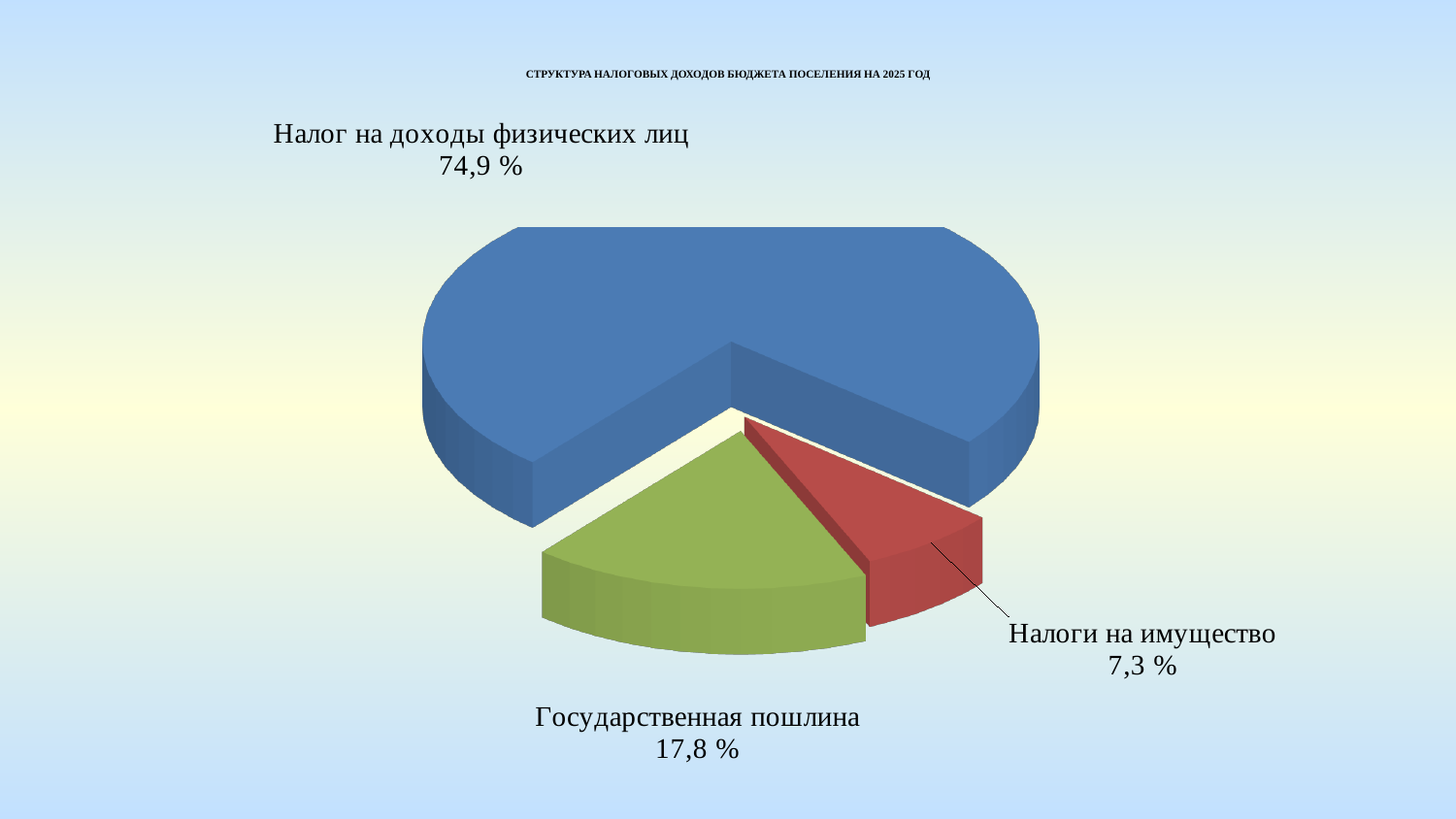
Какова доля налогов на имущество? 7,3 % На сколько процентных пунктов доля налога на доходы физических лиц больше доли государственной пошлины? 57,1 Какая категория имеет наибольшую долю в структуре налоговых доходов? Налог на доходы физических лиц Какой тип диаграммы показан на слайде? Круговая диаграмма Сколько категорий показано на круговой диаграмме? 3 Как называется диаграмма на слайде? Структура налоговых доходов бюджета поселения на 2025 год Какова доля налога на доходы физических лиц в структуре налоговых доходов? 74,9 % Что больше: доля государственной пошлины или доля налогов на имущество? Государственная пошлина Какова доля государственной пошлины? 17,8 % Каким цветом показан сектор «Государственная пошлина»? Зелёным На сколько процентных пунктов доля государственной пошлины больше доли налогов на имущество? 10,5 Какая категория имеет наименьшую долю? Налоги на имущество